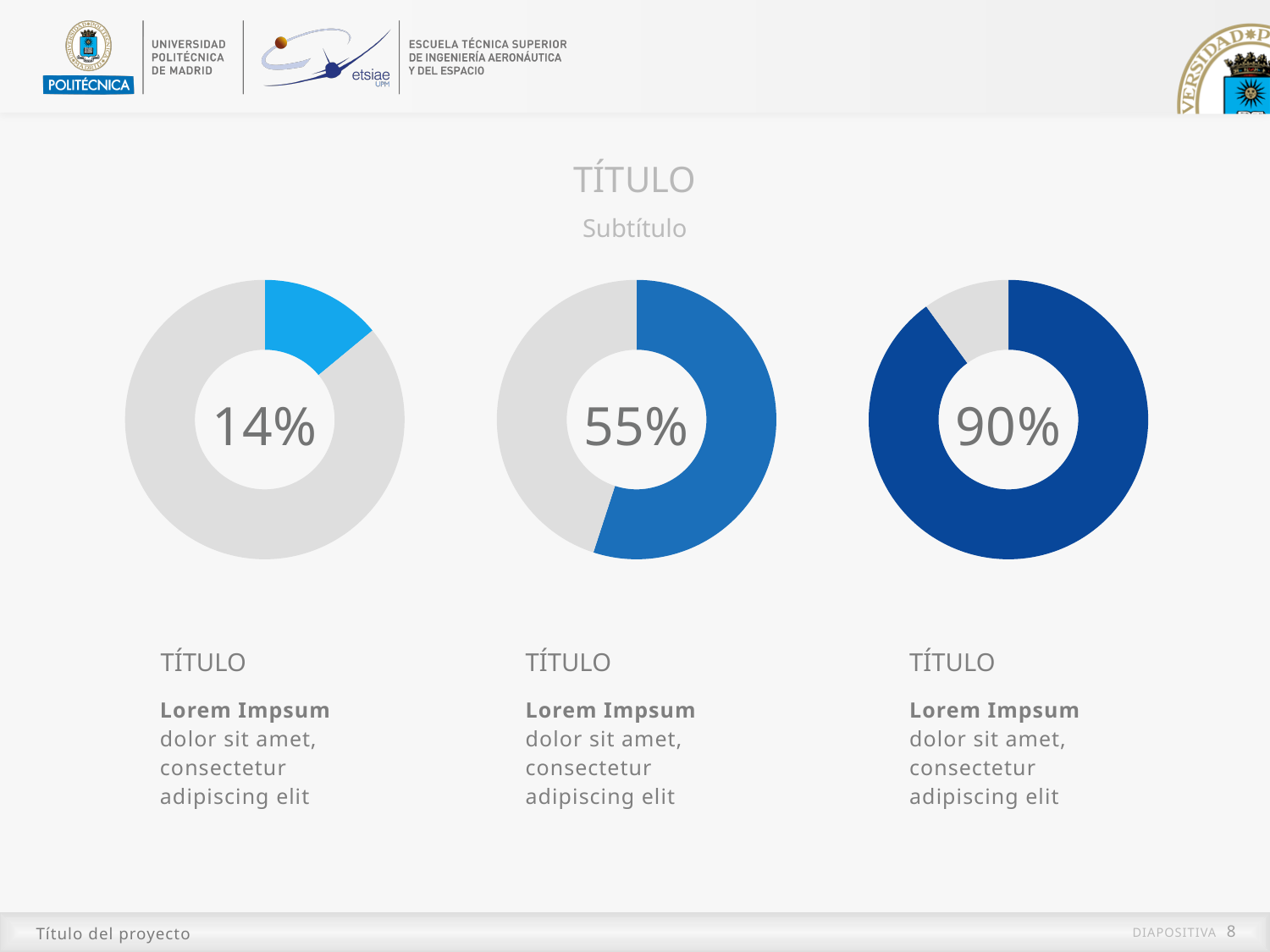
What percentage is shown in the centre of the right donut chart? 90% What percentage is shown in the centre of the left donut chart? 14% How many donut charts are on the slide? 3 Which donut chart shows the highest percentage: left, middle or right? Right Which is larger, the percentage in the middle donut chart or the percentage in the right donut chart? Right (90%) What is the difference between the percentage in the right donut chart and the percentage in the left donut chart? 76% Is the filled share of the left donut chart greater or less than 50%? less Which donut chart shows the lowest percentage: left, middle or right? Left What is the difference between the percentage in the middle donut chart and the percentage in the left donut chart? 41% What kind of chart is used for the three figures on the slide? Donut chart What colour is the filled portion of the left donut chart? Light blue What percentage is shown in the centre of the middle donut chart? 55%